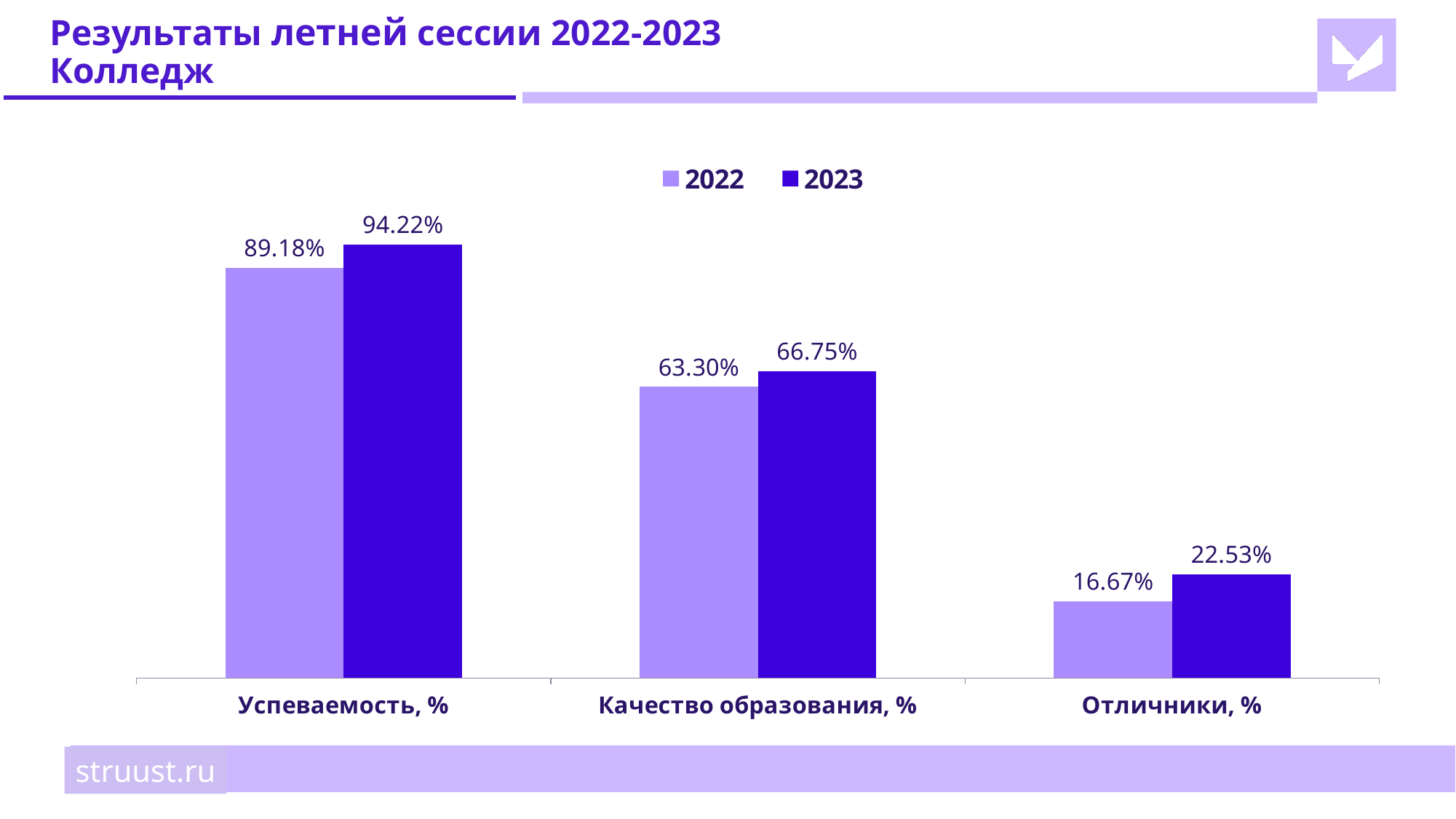
Which category has the lowest value for 2022? Отличники, % What is the value for 2023 in the Успеваемость, % category? 94.22% What is the difference between the 2023 and 2022 values for Отличники, %? 5.86% Which series is shown in the darker purple colour? 2023 What is the value for 2022 in the Отличники, % category? 16.67% What is the difference between the 2023 and 2022 values for Успеваемость, %? 5.04% Which category has the highest value for 2023? Успеваемость, % How many categories are shown on the x axis? 3 What kind of chart is shown on the slide? Bar chart How many series does the legend list? 2 Which is larger for Качество образования, %: the 2022 value or the 2023 value? 2023 What is the value for 2022 in the Качество образования, % category? 63.30%